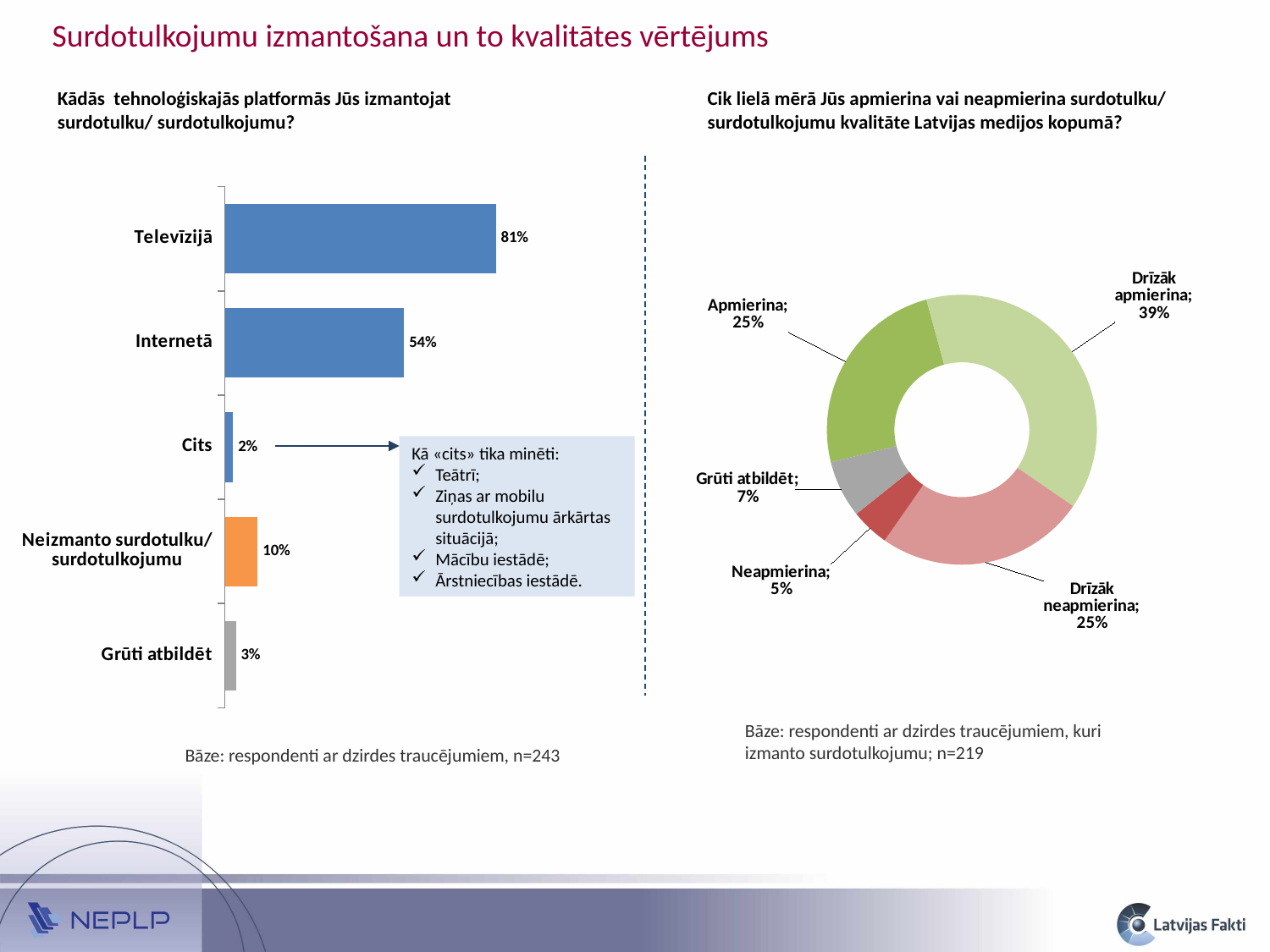
In the left bar chart about technological platforms, which category has the highest value? Televīzijā In the left bar chart about technological platforms, what is the value for Televīzijā? 81% In the left bar chart about technological platforms, how many categories are shown? 5 In the left bar chart about technological platforms, which category has the lowest value? Cits In the right doughnut chart about satisfaction with quality, which is larger: Apmierina or Grūti atbildēt? Apmierina In the right doughnut chart about satisfaction with quality, what is the share for Drīzāk apmierina? 39% In the right doughnut chart about satisfaction with quality, how many categories are shown? 5 In the right doughnut chart about satisfaction with quality, which category has the largest share? Drīzāk apmierina In the right doughnut chart about satisfaction with quality, what is the value for Neapmierina? 5% In the left bar chart about technological platforms, what is the difference between the values for Televīzijā and Internetā? 27% In the left bar chart about technological platforms, what is the value for Internetā? 54% What kind of chart is the left chart about technological platforms? Bar chart